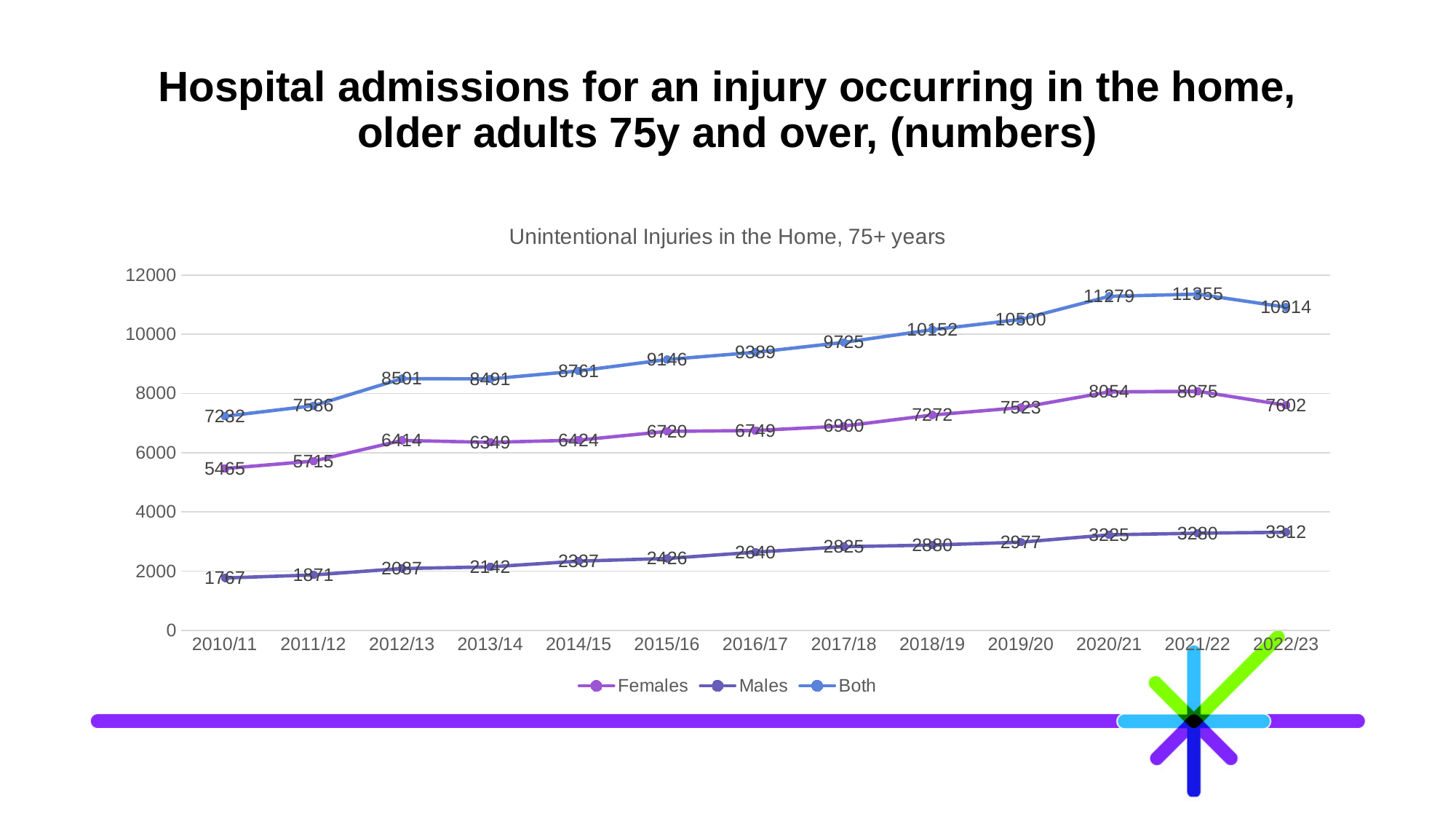
In which year is the Males series lowest? 2010/11 In which year is the Both series highest? 2021/22 What is the title shown above the plot area of the chart? Unintentional Injuries in the Home, 75+ years What is the value for Females in 2018/19? 7272 What is the value for Both in 2021/22? 11355 Is the value for Males in 2022/23 greater or less than 4000? less How many series does the legend list? 3 What is the difference between the Both values for 2020/21 and 2022/23? 365 Which is larger, the Females value in 2012/13 or in 2013/14? 2012/13 What type of chart is shown on the slide? line chart What is the value for Males in 2019/20? 2977 How many years are plotted along the x axis? 13